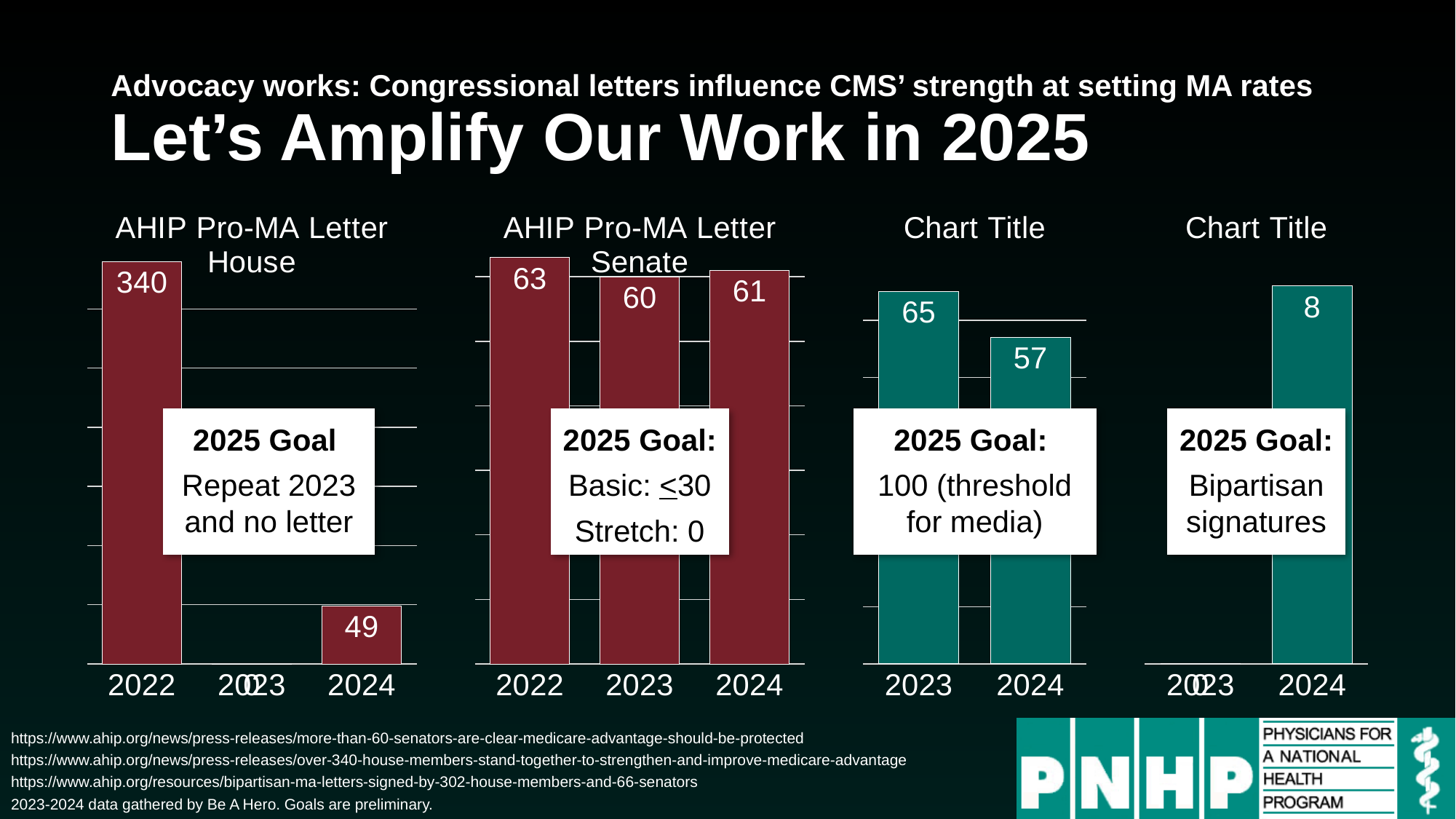
In the AHIP Pro-MA Letter Senate chart, how many years are shown on the x axis? 3 What kind of chart is the AHIP Pro-MA Letter House chart? Bar chart In the AHIP Pro-MA Letter Senate chart, which year has the lowest value? 2023 In the AHIP Pro-MA Letter House chart, which year has the highest value? 2022 In the AHIP Pro-MA Letter House chart, what is the value for 2022? 340 In the third chart from the left (titled Chart Title), what is the value for 2023? 65 In the rightmost chart (titled Chart Title), what is the value for 2024? 8 In the AHIP Pro-MA Letter House chart, what is the value for 2024? 49 In the AHIP Pro-MA Letter Senate chart, what is the value for 2023? 60 In the third chart from the left (titled Chart Title), what is the difference between the 2023 and 2024 values? 8 In the AHIP Pro-MA Letter House chart, what is the difference between the 2022 and 2024 values? 291 In the third chart from the left (titled Chart Title), which year has the larger value, 2023 or 2024? 2023